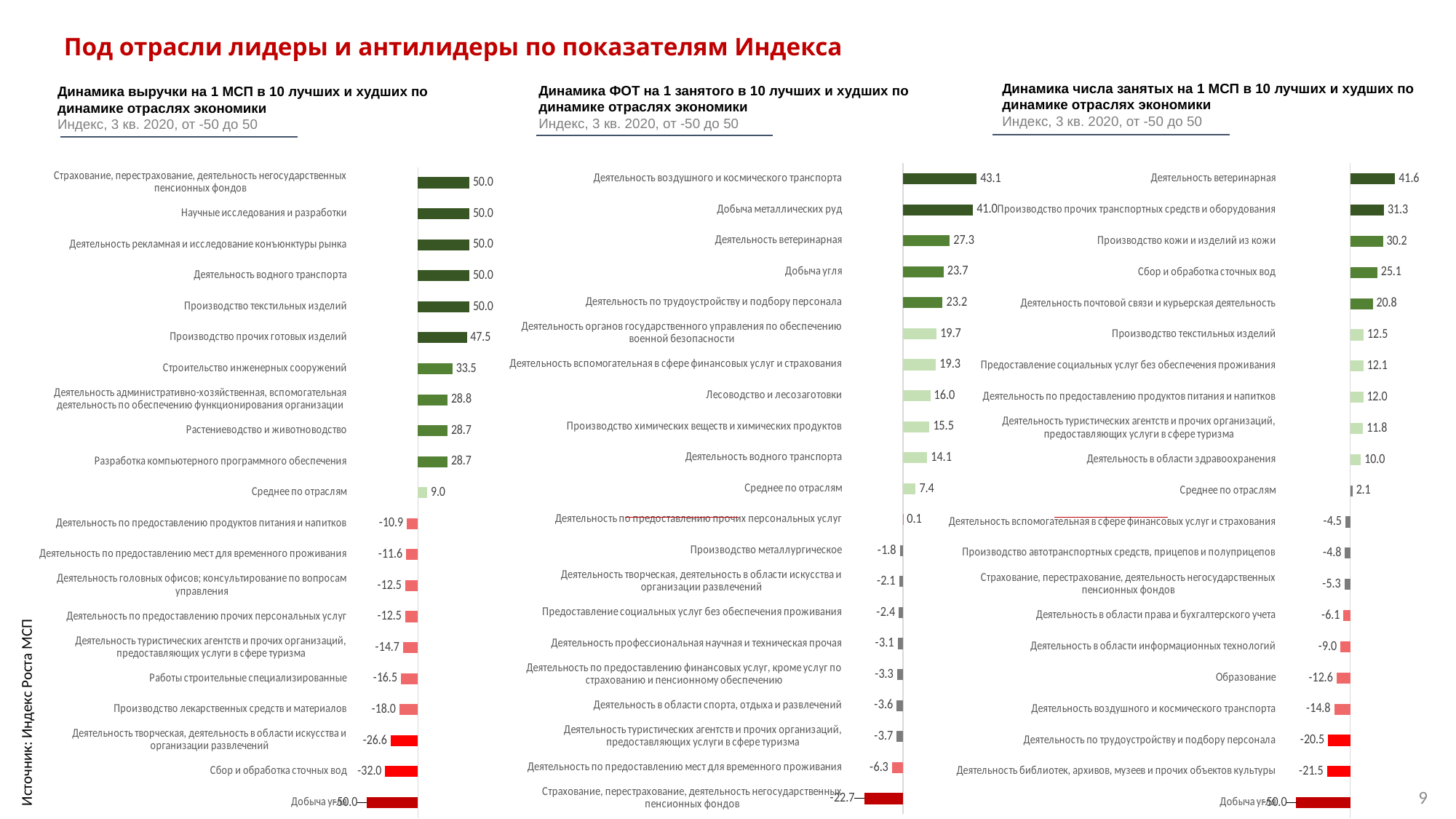
In the chart 'Динамика выручки на 1 МСП в 10 лучших и худших по динамике отраслях экономики', what is the value for 'Сбор и обработка сточных вод'? -32.0 What type of chart is 'Динамика выручки на 1 МСП в 10 лучших и худших по динамике отраслях экономики'? Bar chart In the chart 'Динамика ФОТ на 1 занятого в 10 лучших и худших по динамике отраслях экономики', which category has the lowest value? Страхование, перестрахование, деятельность негосударственных пенсионных фондов In the chart 'Динамика числа занятых на 1 МСП в 10 лучших и худших по динамике отраслях экономики', which is larger: 'Производство кожи и изделий из кожи' or 'Сбор и обработка сточных вод'? Производство кожи и изделий из кожи In the chart 'Динамика ФОТ на 1 занятого в 10 лучших и худших по динамике отраслях экономики', what is the difference between 'Деятельность воздушного и космического транспорта' and 'Добыча металлических руд'? 2.1 In the chart 'Динамика ФОТ на 1 занятого в 10 лучших и худших по динамике отраслях экономики', which category has the highest value? Деятельность воздушного и космического транспорта How many categories are shown in the chart 'Динамика числа занятых на 1 МСП в 10 лучших и худших по динамике отраслях экономики'? 21 In the chart 'Динамика выручки на 1 МСП в 10 лучших и худших по динамике отраслях экономики', what is the value for 'Среднее по отраслям'? 9.0 In the chart 'Динамика числа занятых на 1 МСП в 10 лучших и худших по динамике отраслях экономики', what is the value for 'Деятельность ветеринарная'? 41.6 In the chart 'Динамика ФОТ на 1 занятого в 10 лучших и худших по динамике отраслях экономики', what is the value for 'Добыча угля'? 23.7 In the chart 'Динамика числа занятых на 1 МСП в 10 лучших и худших по динамике отраслях экономики', what is the value for 'Образование'? -12.6 In the chart 'Динамика выручки на 1 МСП в 10 лучших и худших по динамике отраслях экономики', what is the value for 'Строительство инженерных сооружений'? 33.5